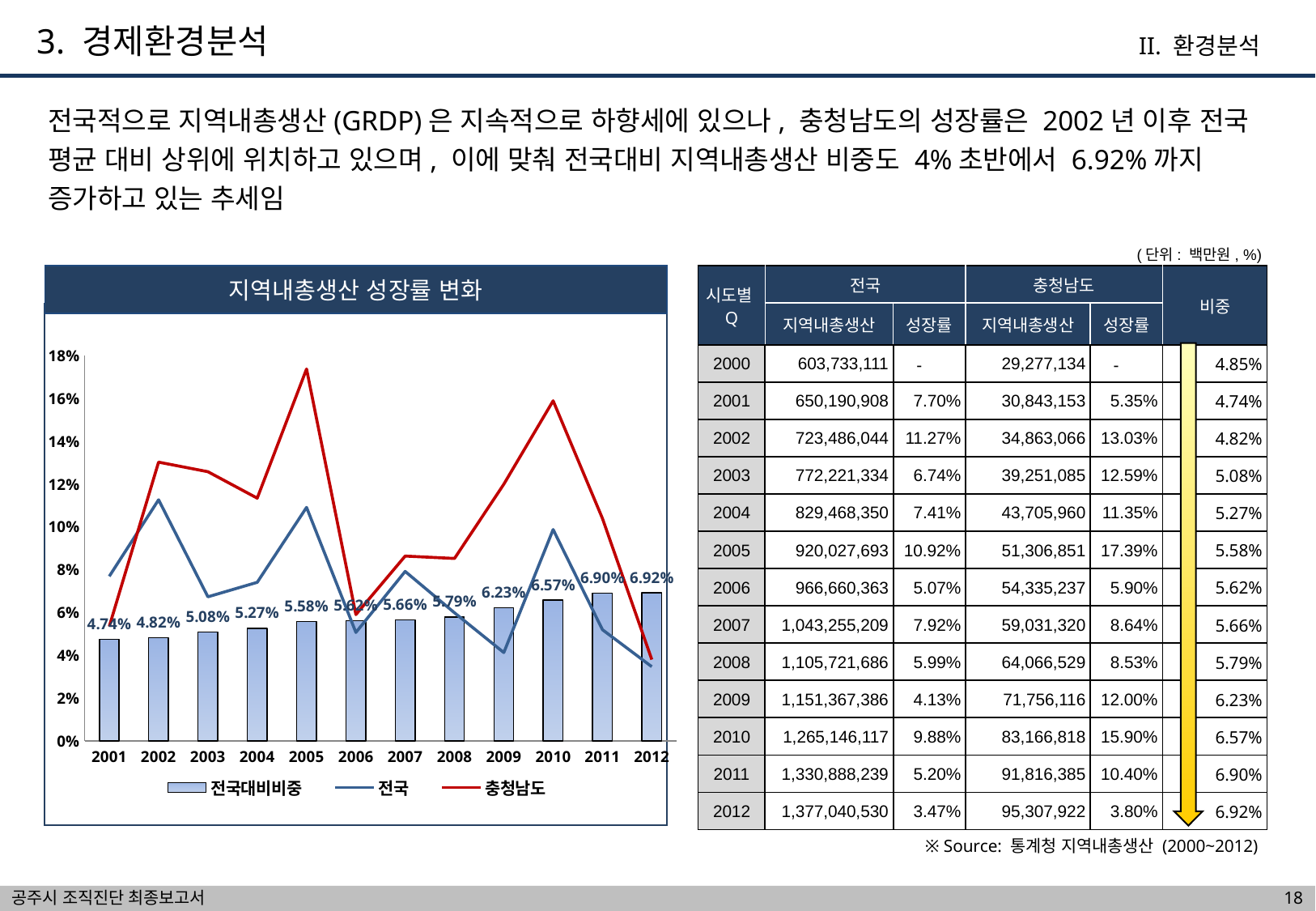
How many years are shown on the x axis of the chart? 12 What kind of chart is shown on the slide? Combined bar and line chart How many series does the chart legend list? 3 Do the 전국대비비중 bars rise or fall from 2001 to 2012? rise Is the value of the 충청남도 line in 2005 greater or less than 16%? greater What is the value of the 전국대비비중 bar for 2005? 5.58% Which year has the lowest 전국대비비중 bar? 2001 Which year has the highest 전국대비비중 bar? 2012 Is the value of the 전국 line in 2012 greater or less than 4%? less What is the value of the 전국대비비중 bar for 2010? 6.57% Which year has a larger 전국대비비중 value, 2008 or 2009? 2009 What is the difference between the 전국대비비중 values for 2012 and 2001? 2.18 percentage points